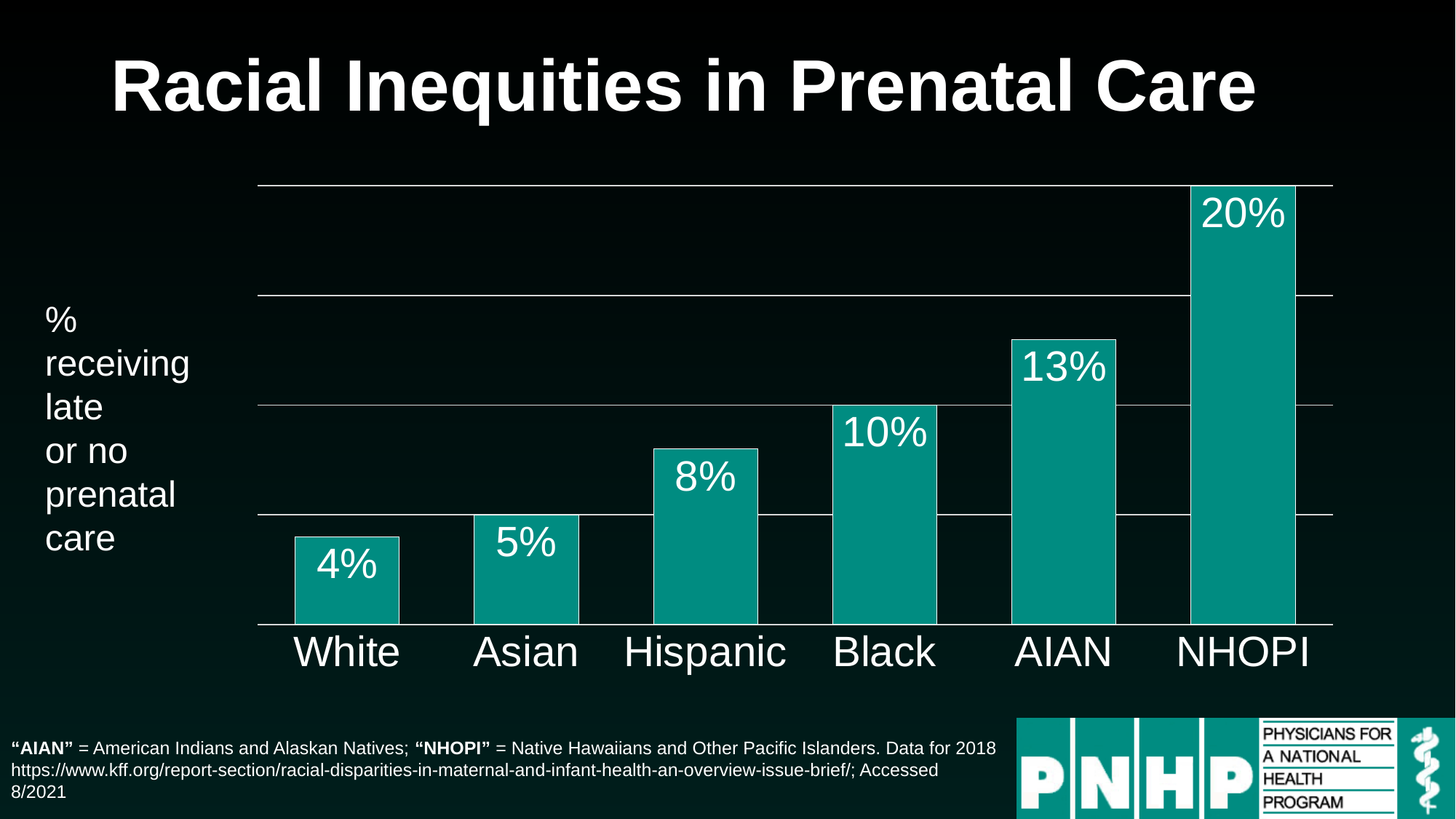
What is the difference between the Hispanic value and the Asian value? 3% What is the value shown for Black in the chart? 10% Which group has the highest percentage receiving late or no prenatal care? NHOPI What is the title of the slide containing the chart? Racial Inequities in Prenatal Care How many racial/ethnic groups are shown in the chart? 6 What is the difference between the NHOPI value and the White value? 16% Which is larger, the value for Black or the value for Hispanic? Black What kind of chart is shown on the slide? Bar chart Do the values rise or fall moving from left to right across the categories? Rise Which group has the lowest percentage receiving late or no prenatal care? White What is the value shown for AIAN in the chart? 13% What percentage of White mothers received late or no prenatal care? 4%